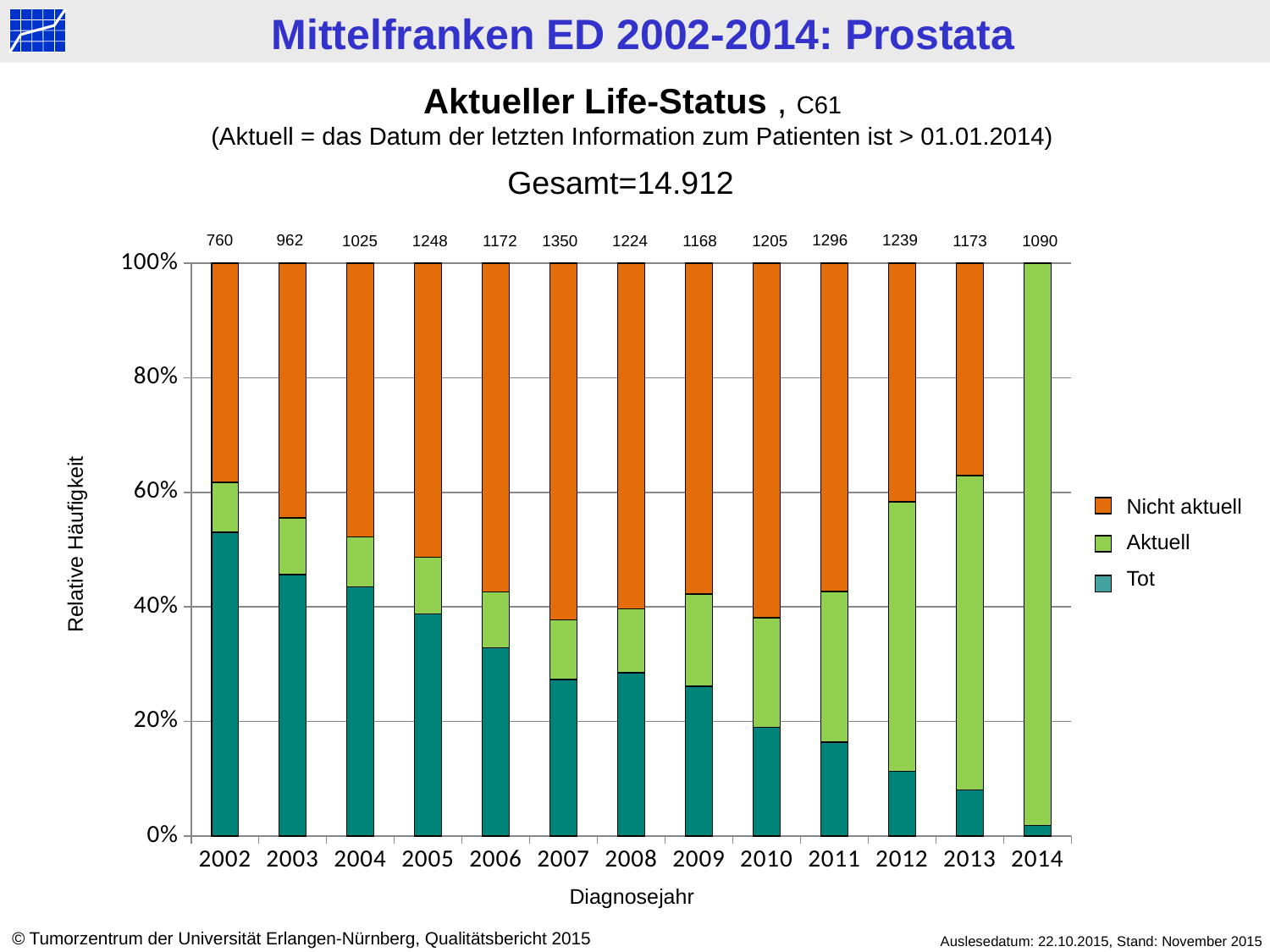
Which diagnosis year has the lowest number printed above its bar? 2002 What is the number printed above the bar for 2002? 760 What is the difference between the numbers printed above the bars for 2007 and 2002? 590 Which diagnosis year has the highest number printed above its bar? 2007 What is the number printed above the bar for 2007? 1350 Does the 'Tot' share rise or fall from 2002 to 2014? fall How many series does the legend list? 3 Is the 'Tot' share for 2002 greater or less than 40%? greater Which has the larger number printed above its bar, 2005 or 2011? 2011 What kind of chart is shown on the slide? stacked bar chart Is the 'Tot' share for 2013 greater or less than 20%? less How many diagnosis years are shown on the x axis? 13